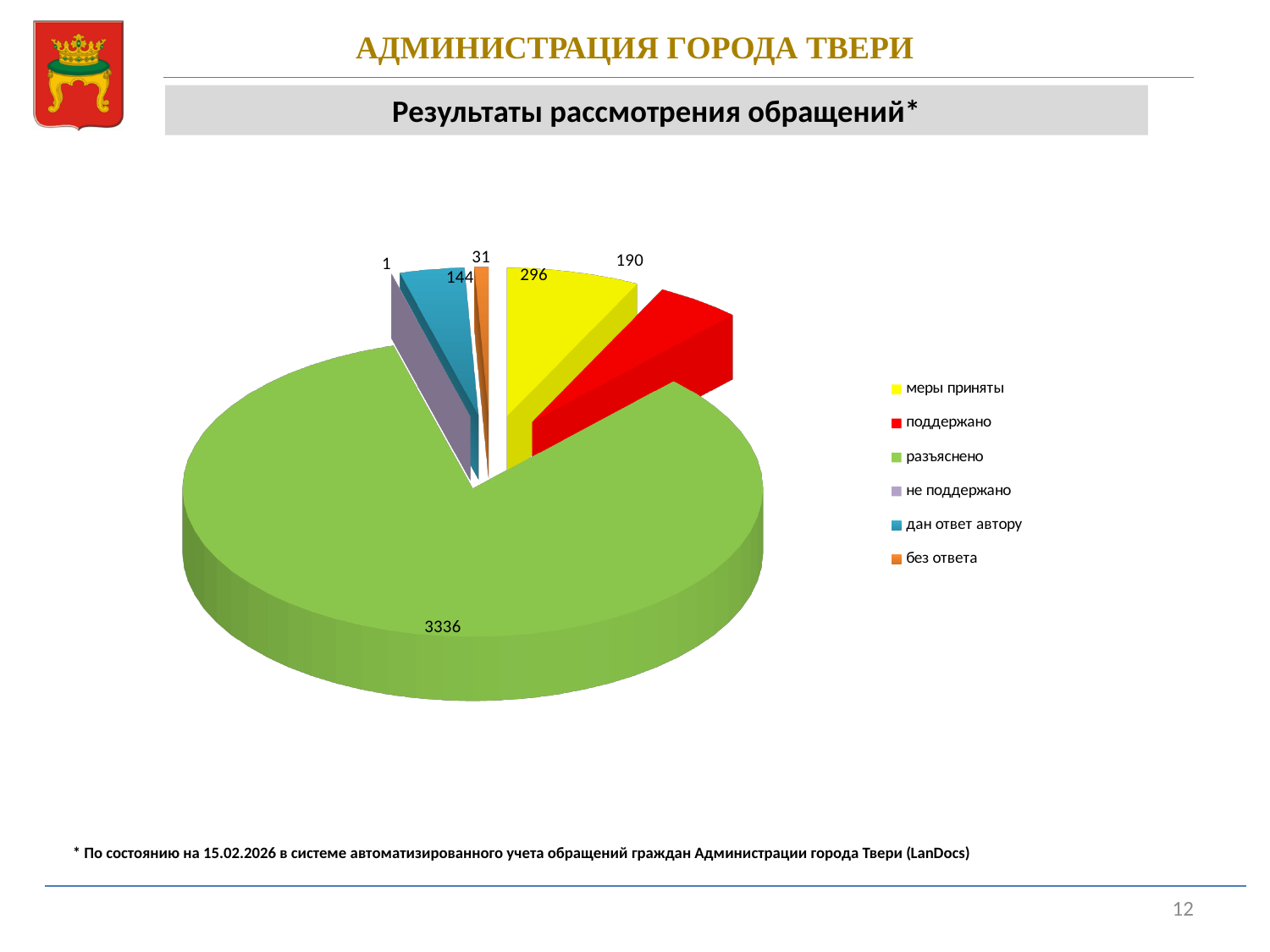
What is the value for меры приняты? 296 Which category has the largest slice? разъяснено What is the value for разъяснено? 3336 Which category has the smallest slice? не поддержано What is the difference between the values for меры приняты and поддержано? 106 What kind of chart is shown on the slide? pie chart What is the value for дан ответ автору? 144 Which is larger, the value for дан ответ автору or the value for без ответа? дан ответ автору What is the title of the chart? Результаты рассмотрения обращений* What is the value for без ответа? 31 What is the value for поддержано? 190 How many categories does the legend list? 6